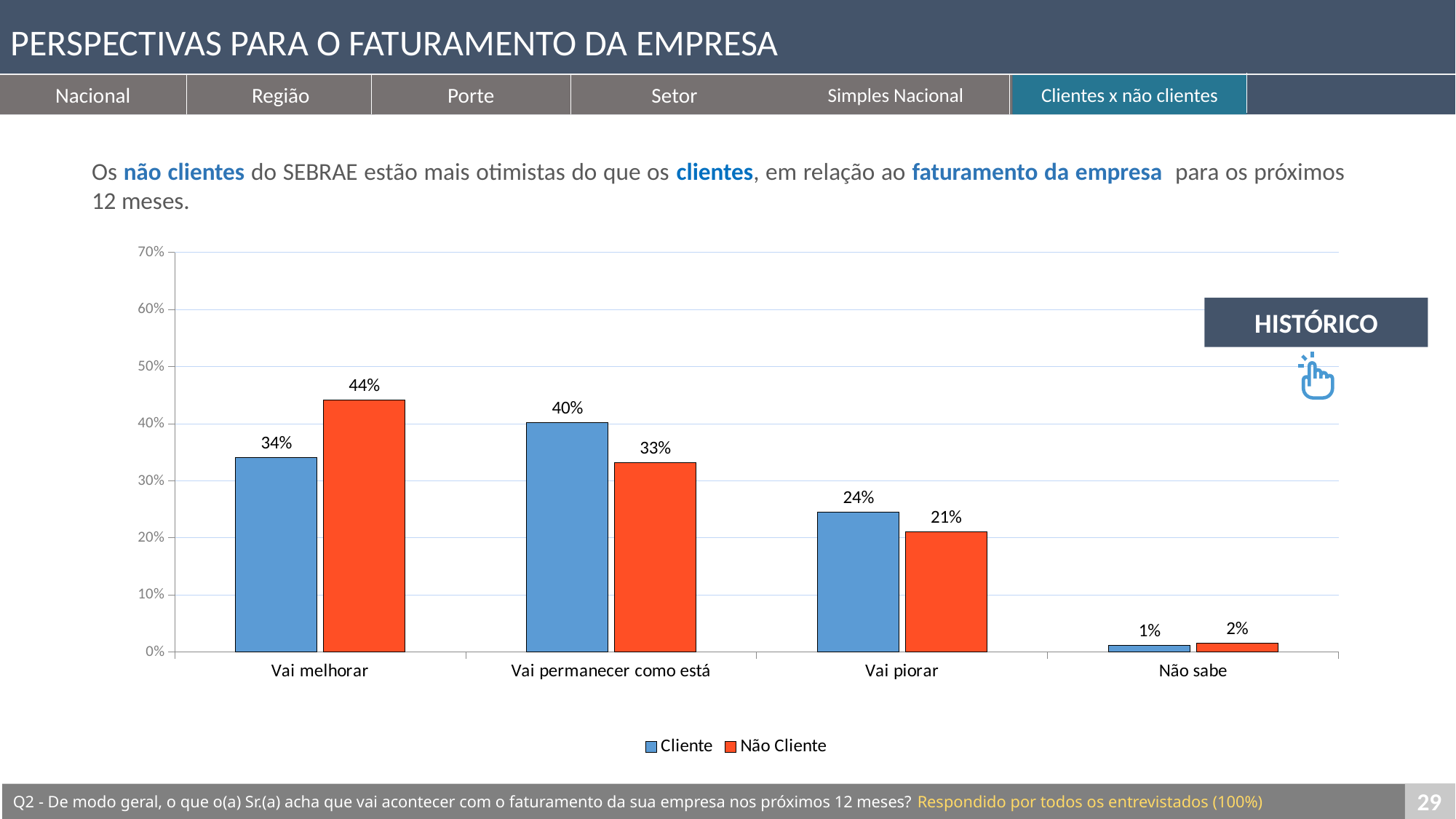
Which category has the highest value for the Não Cliente series? Vai melhorar What kind of chart is shown on the slide? Bar chart What is the difference between the Não Cliente and Cliente values in the 'Vai melhorar' category? 10% What is the value for Cliente in the 'Vai melhorar' category? 34% Which category has the lowest value for the Cliente series? Não sabe What is the value for Não Cliente in the 'Vai piorar' category? 21% In the 'Vai permanecer como está' category, which series has the larger value, Cliente or Não Cliente? Cliente What colour are the bars for the Não Cliente series? Red/orange What is the value for Cliente in the 'Vai permanecer como está' category? 40% What is the value for Não Cliente in the 'Vai melhorar' category? 44% How many categories are shown on the x axis? 4 How many series does the legend list? 2